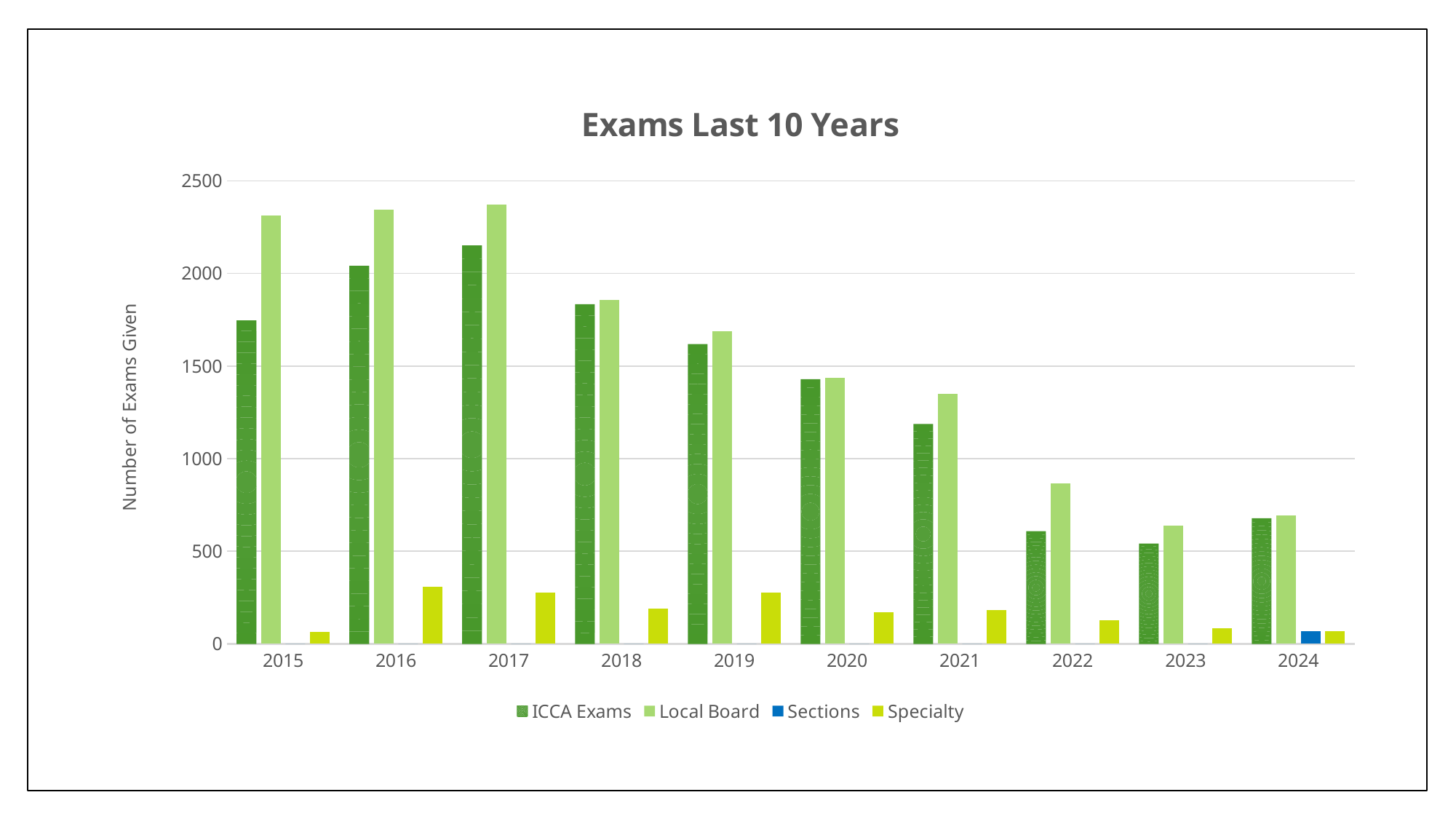
What type of chart is shown on the slide? bar chart Is the value for ICCA Exams in 2022 greater or less than 1000? less In which year is the ICCA Exams value lowest? 2023 In 2021, which is larger: ICCA Exams or Local Board? Local Board What is the title of the chart? Exams Last 10 Years Is the value for Local Board in 2015 greater or less than 2000? greater Is the value for Specialty in 2016 greater or less than 500? less Do the Local Board values rise or fall from 2017 to 2023? fall How many series does the legend list? 4 How many years are shown on the x axis? 10 What is the label of the vertical axis? Number of Exams Given In which year is the ICCA Exams value highest? 2017